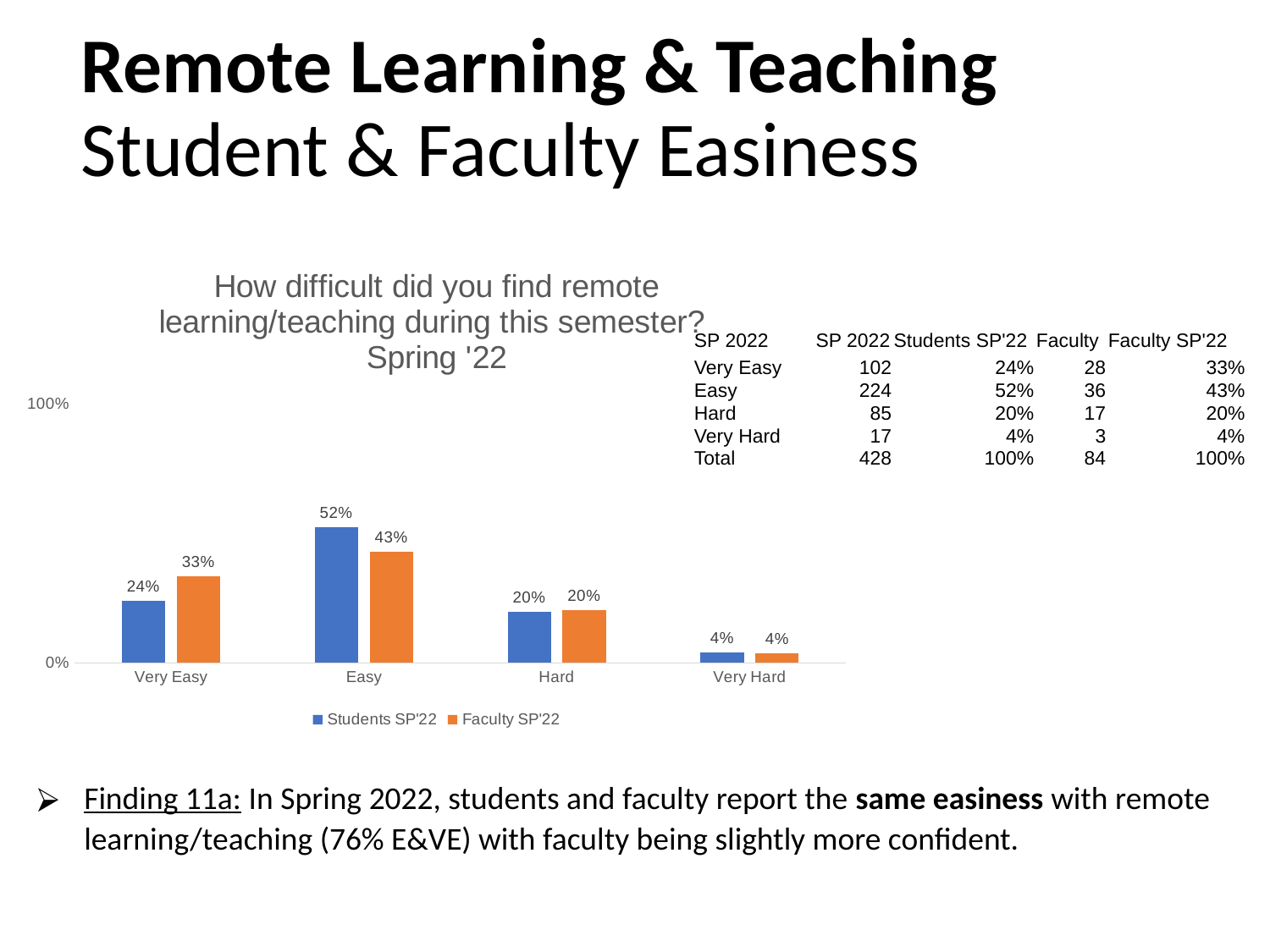
Do the Students SP'22 values rise or fall from Easy to Very Hard along the x axis? Fall What colour are the Faculty SP'22 bars in the chart? Orange What kind of chart is shown on the slide? Bar chart What is the value for Faculty SP'22 in the Hard category? 20% Which category has the highest value for Students SP'22? Easy In the Very Easy category, which series has the larger value, Students SP'22 or Faculty SP'22? Faculty SP'22 How many categories are shown on the x axis of the chart? 4 What is the value for Students SP'22 in the Easy category? 52% How many series does the chart legend list? 2 What is the difference between the Students SP'22 and Faculty SP'22 values in the Easy category? 9% Which category has the lowest value for Faculty SP'22? Very Hard What is the value for Faculty SP'22 in the Very Easy category? 33%